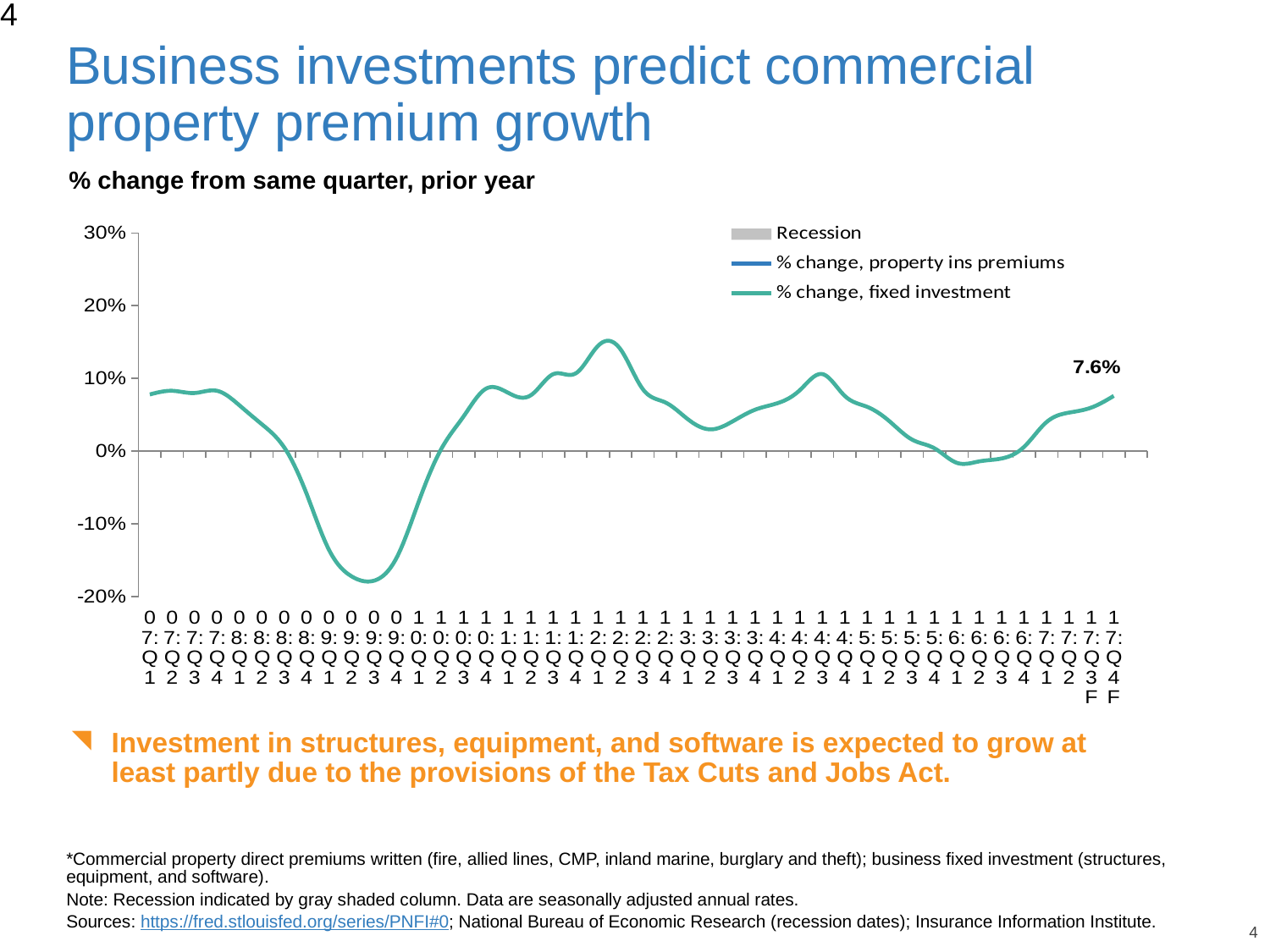
Does the fixed investment line rise or fall between 16:Q4 and 17:Q4 F? rise Is the value of the fixed investment line at 09:Q3 greater or less than -10%? less What is the subtitle printed above the chart describing the measure plotted? % change from same quarter, prior year What value is labeled at the end of the fixed investment line (17:Q4 F)? 7.6% Does the fixed investment line rise or fall between 08:Q1 and 09:Q3? fall Is the value of the fixed investment line at 07:Q1 greater or less than 0%? greater How many entries does the chart legend list? 3 At which quarter does the fixed investment line reach its lowest point? 09:Q3 At which quarter does the fixed investment line reach its highest point? 12:Q1 Is the value of the fixed investment line at 16:Q2 greater or less than 0%? less What kind of chart is shown on the slide? line chart